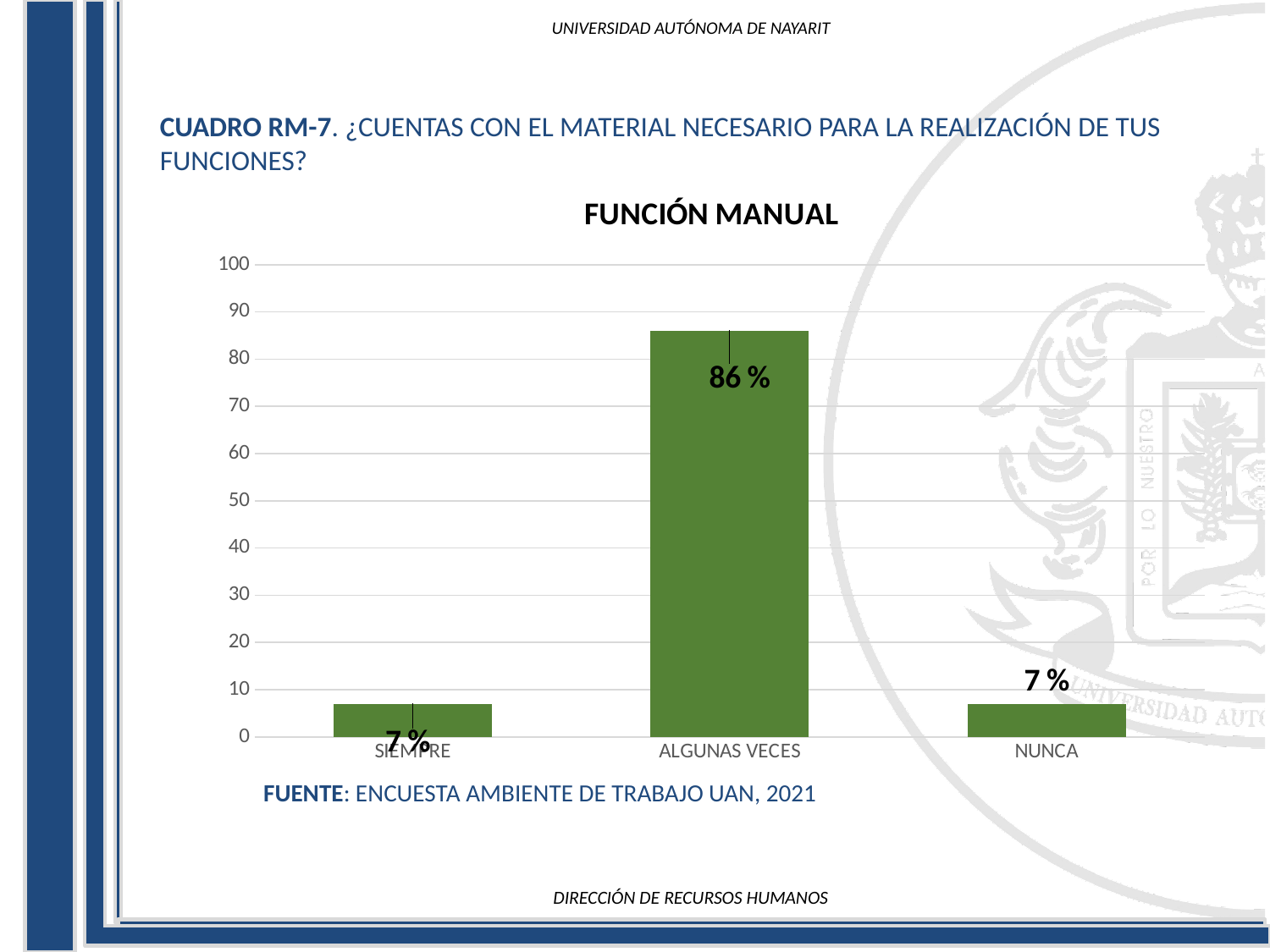
What is the value for NUNCA? 7 % What is the title of the chart? FUNCIÓN MANUAL Which category has the highest value? ALGUNAS VECES Is the value for NUNCA greater or less than 10? less What is the value for ALGUNAS VECES? 86 % What is the value for SIEMPRE? 7 % What is the difference between the values for ALGUNAS VECES and NUNCA? 79 % What is the highest value shown on the y axis? 100 Which is larger, the value for ALGUNAS VECES or the value for SIEMPRE? ALGUNAS VECES What kind of chart is shown on the slide? bar chart Is the value for ALGUNAS VECES greater or less than 80? greater How many categories are shown on the x axis? 3